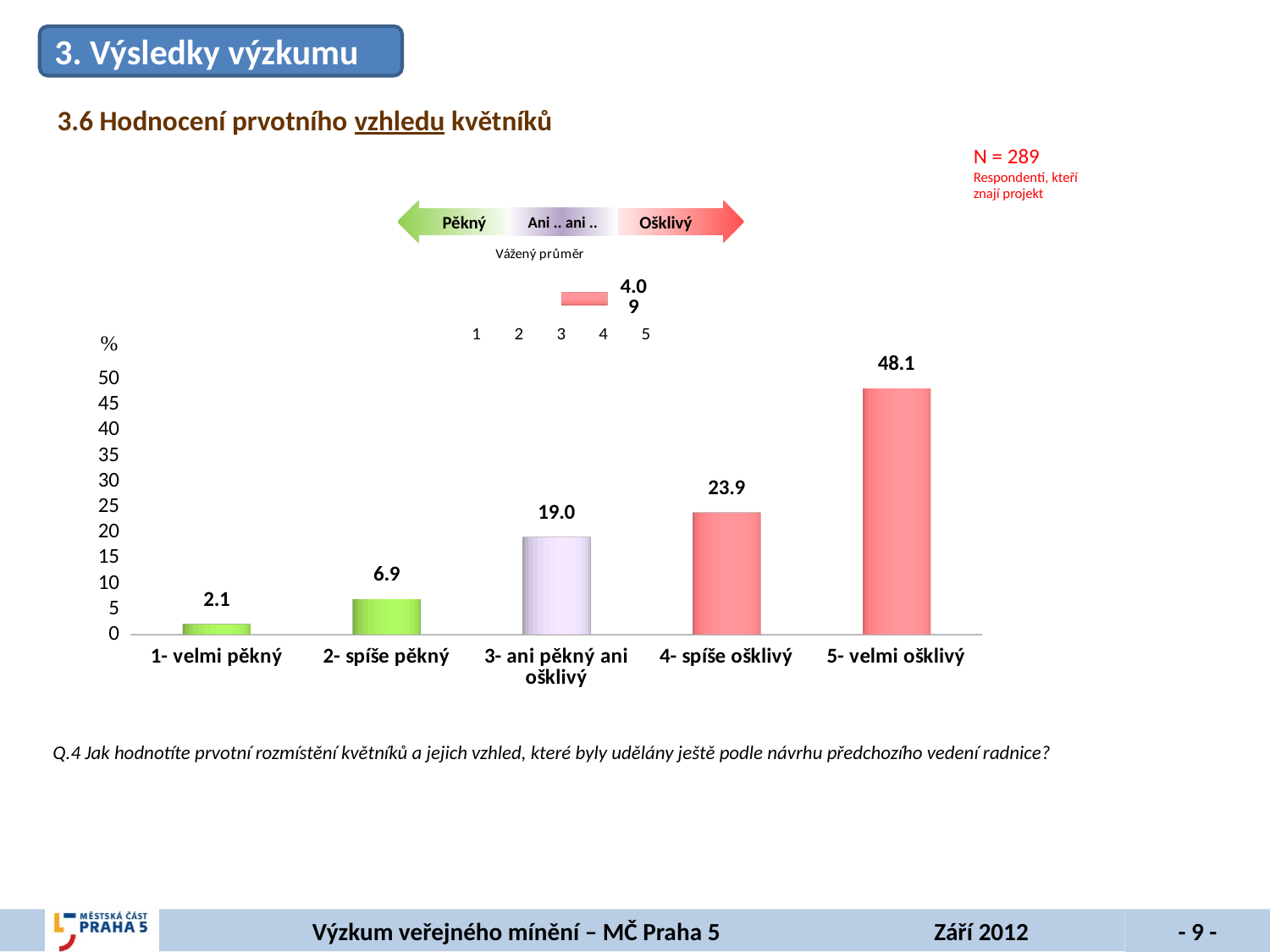
In the main bar chart, which is larger: the value for "4- spíše ošklivý" or the value for "3- ani pěkný ani ošklivý"? 4- spíše ošklivý In the main bar chart, what is the value for "3- ani pěkný ani ošklivý"? 19.0 In the main bar chart, which category has the highest value? 5- velmi ošklivý How many categories are shown on the x axis of the main bar chart? 5 In the main bar chart, which category has the lowest value? 1- velmi pěkný In the main bar chart, what is the difference between the values for "5- velmi ošklivý" and "4- spíše ošklivý"? 24.2 In the main bar chart, what is the value for "1- velmi pěkný"? 2.1 What kind of chart is the main chart on the slide? bar chart In the main bar chart, do the values rise or fall from "1- velmi pěkný" to "5- velmi ošklivý"? rise In the main bar chart, what is the difference between the values for "2- spíše pěkný" and "1- velmi pěkný"? 4.8 What weighted average (Vážený průměr) value is shown in the small chart above the main bar chart? 4.09 In the main bar chart, what is the value for "5- velmi ošklivý"? 48.1